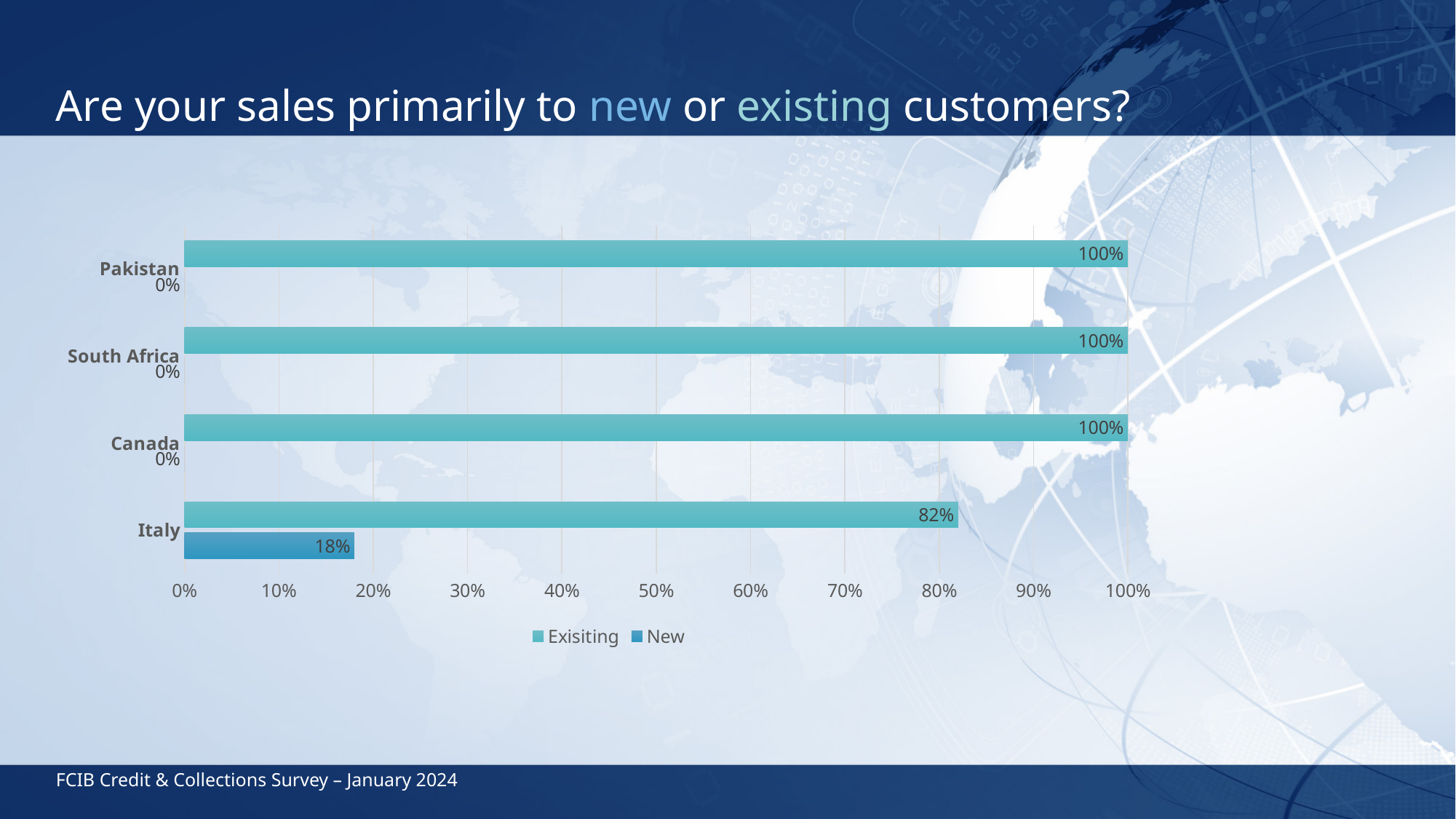
How many series does the legend list? 2 What is the difference between Italy's existing and new customer percentages? 64% What are the two series names listed in the legend? Exisiting and New What is the value for Canada in the Exisiting series? 100% Which country has the highest value for new customers? Italy Which is larger for Italy: the Exisiting value or the New value? Exisiting What percentage of Italy's sales are to existing customers? 82% What kind of chart is shown on the slide? Bar chart What percentage of Italy's sales are to new customers? 18% How many countries are shown on the chart? 4 What is the value for Pakistan in the New series? 0% Which country has the lowest value for existing customers? Italy